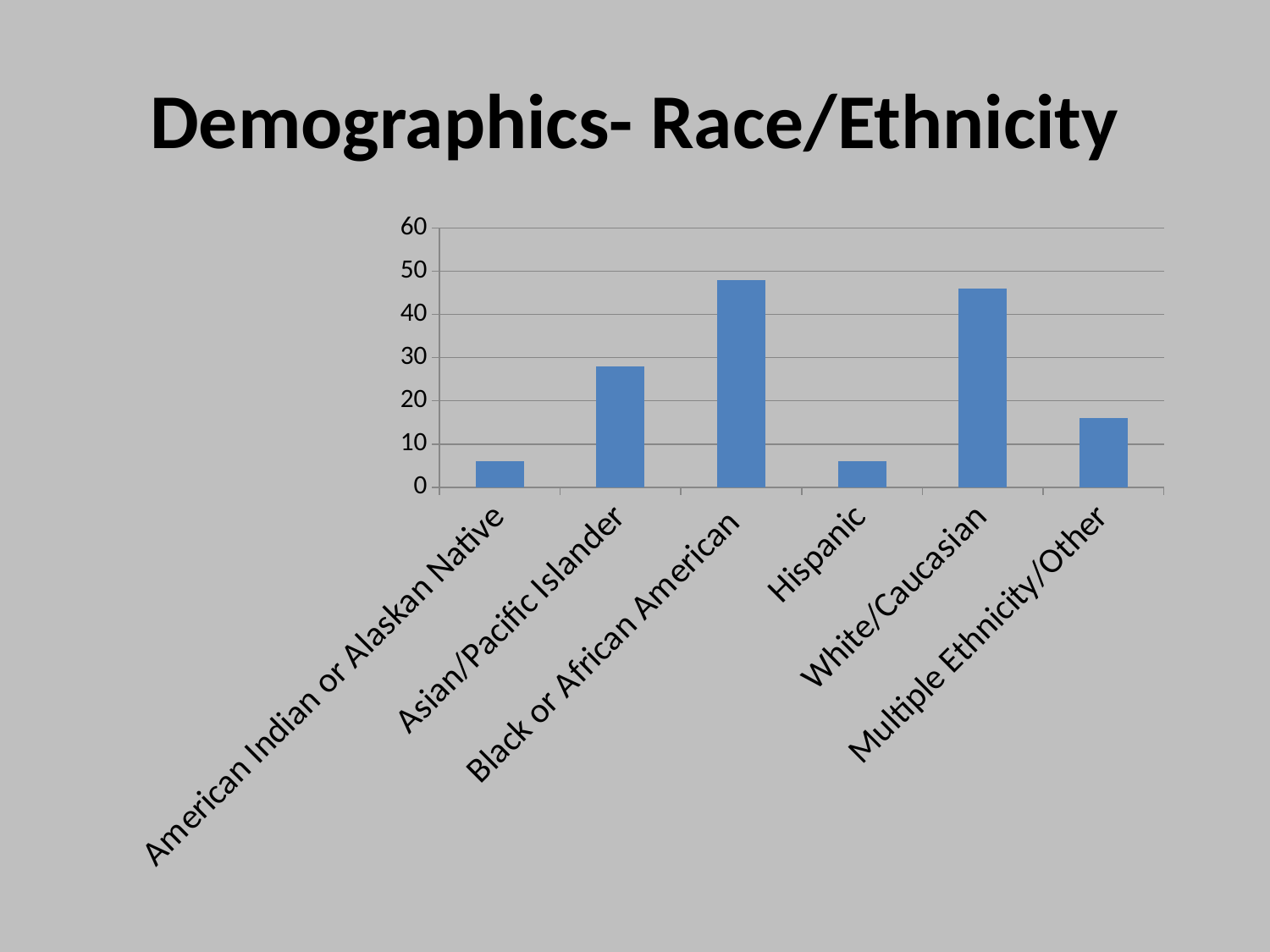
Is the value for Black or African American greater or less than 40? greater Is the value for American Indian or Alaskan Native greater or less than 10? less Which category has the highest bar on the chart? Black or African American Is the value for Multiple Ethnicity/Other greater or less than 20? less Which is larger, the value for Asian/Pacific Islander or the value for Multiple Ethnicity/Other? Asian/Pacific Islander Which is larger, the value for White/Caucasian or the value for Hispanic? White/Caucasian What is the title of the slide containing the chart? Demographics- Race/Ethnicity What kind of chart is shown on the slide? bar chart How many race/ethnicity categories are plotted on the chart? 6